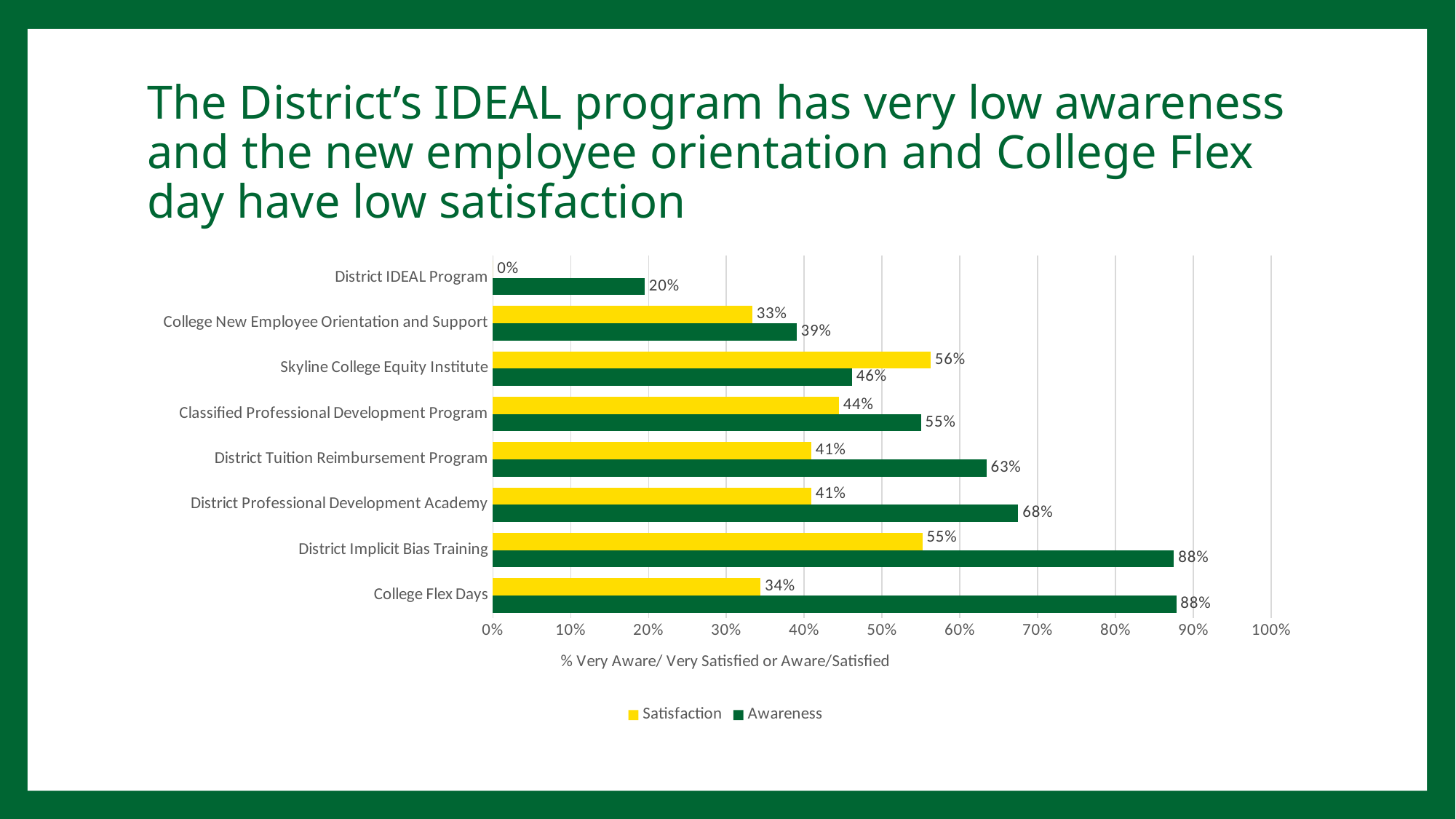
Which category has the highest Satisfaction value? Skyline College Equity Institute How many categories are shown on the chart? 8 Which category has the lowest Satisfaction value? District IDEAL Program What is the Satisfaction value for Skyline College Equity Institute? 56% What is the Awareness value for District IDEAL Program? 20% What is the Satisfaction value for College Flex Days? 34% Is the Awareness value for District Professional Development Academy greater or less than 60%? greater Which is larger for Skyline College Equity Institute: Satisfaction or Awareness? Satisfaction What kind of chart is shown on the slide? Bar chart How many series does the legend list? 2 What is the difference between the Awareness and Satisfaction values for District Implicit Bias Training? 33% What is the x-axis title of the chart? % Very Aware/ Very Satisfied or Aware/Satisfied